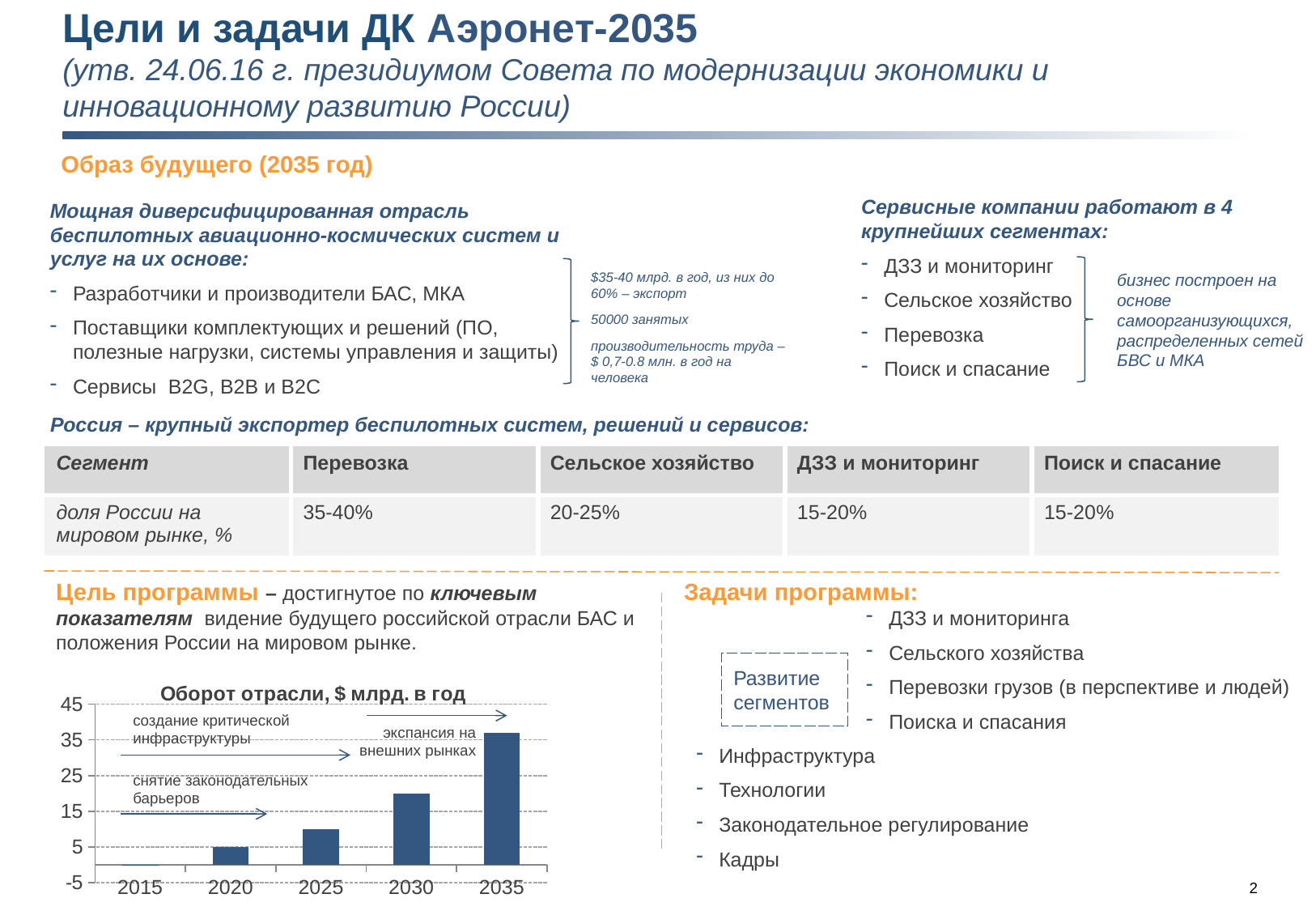
What kind of chart is shown on the slide? bar chart Is the value for 2035 greater or less than 35? greater Do the values in the chart rise or fall from 2015 to 2035? rise Which is larger, the value for 2030 or the value for 2025? 2030 Is the value for 2015 greater or less than 5? less What is the title of the chart on the slide? Оборот отрасли, $ млрд. в год How many years are shown on the x axis of the chart? 5 Is the value for 2030 greater or less than 15? greater Which year has the lowest value in the chart? 2015 Which year has the highest value in the chart? 2035